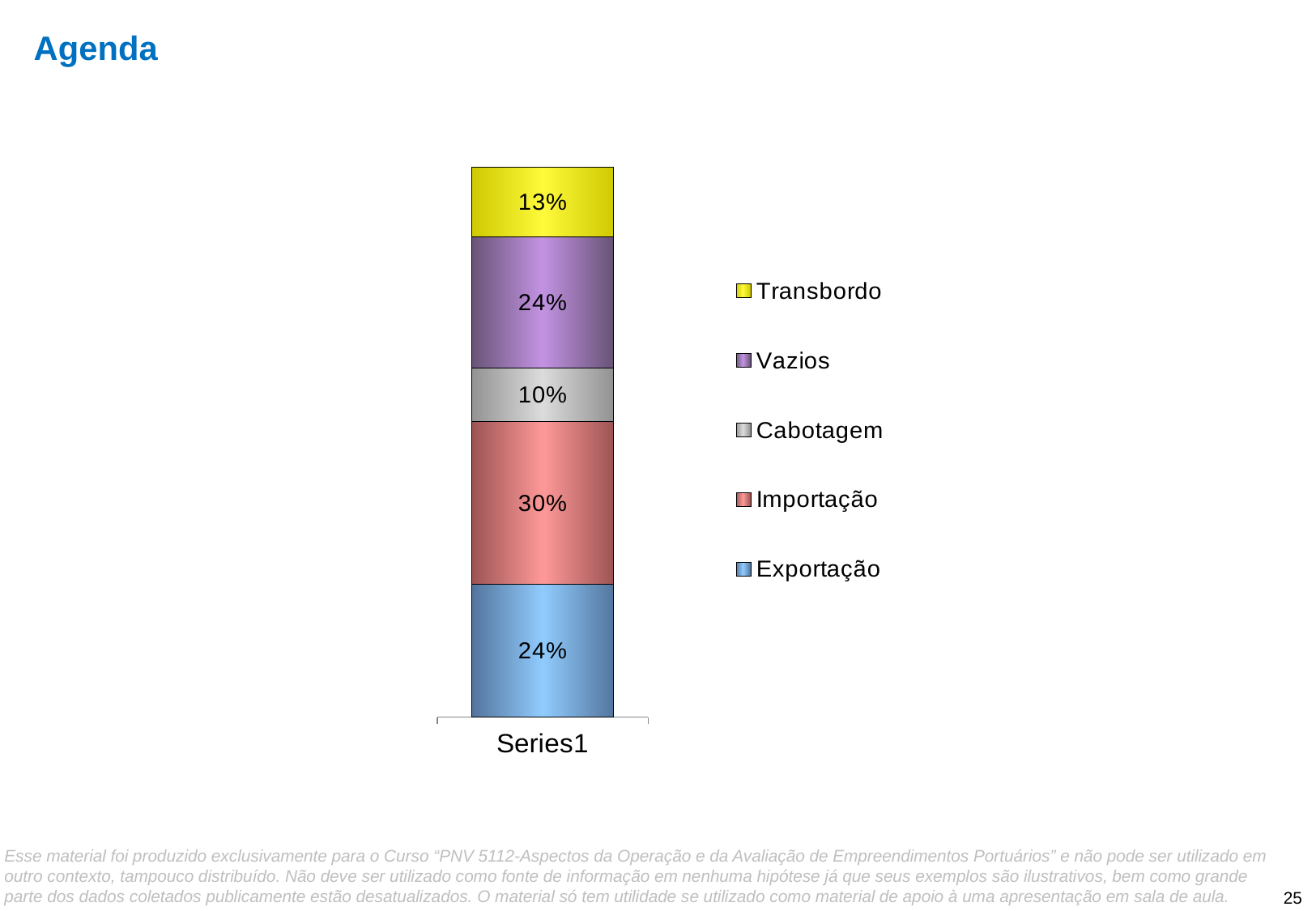
What is the difference between the Importação and Cabotagem values? 20 percentage points What kind of chart is shown on the slide? Stacked bar chart How many series does the legend list? 5 How many bars are plotted in the chart? 1 Which series has the smallest share of the stacked bar? Cabotagem What is the value shown for Cabotagem? 10% What value is shown for Exportação? 24% Which is larger, the Transbordo value or the Vazios value? Vazios What percentage does the Importação segment show in the stacked bar? 30% What percentage is labelled on the Transbordo segment? 13% Which series has the largest share of the stacked bar? Importação Which series is shown in yellow in the legend? Transbordo